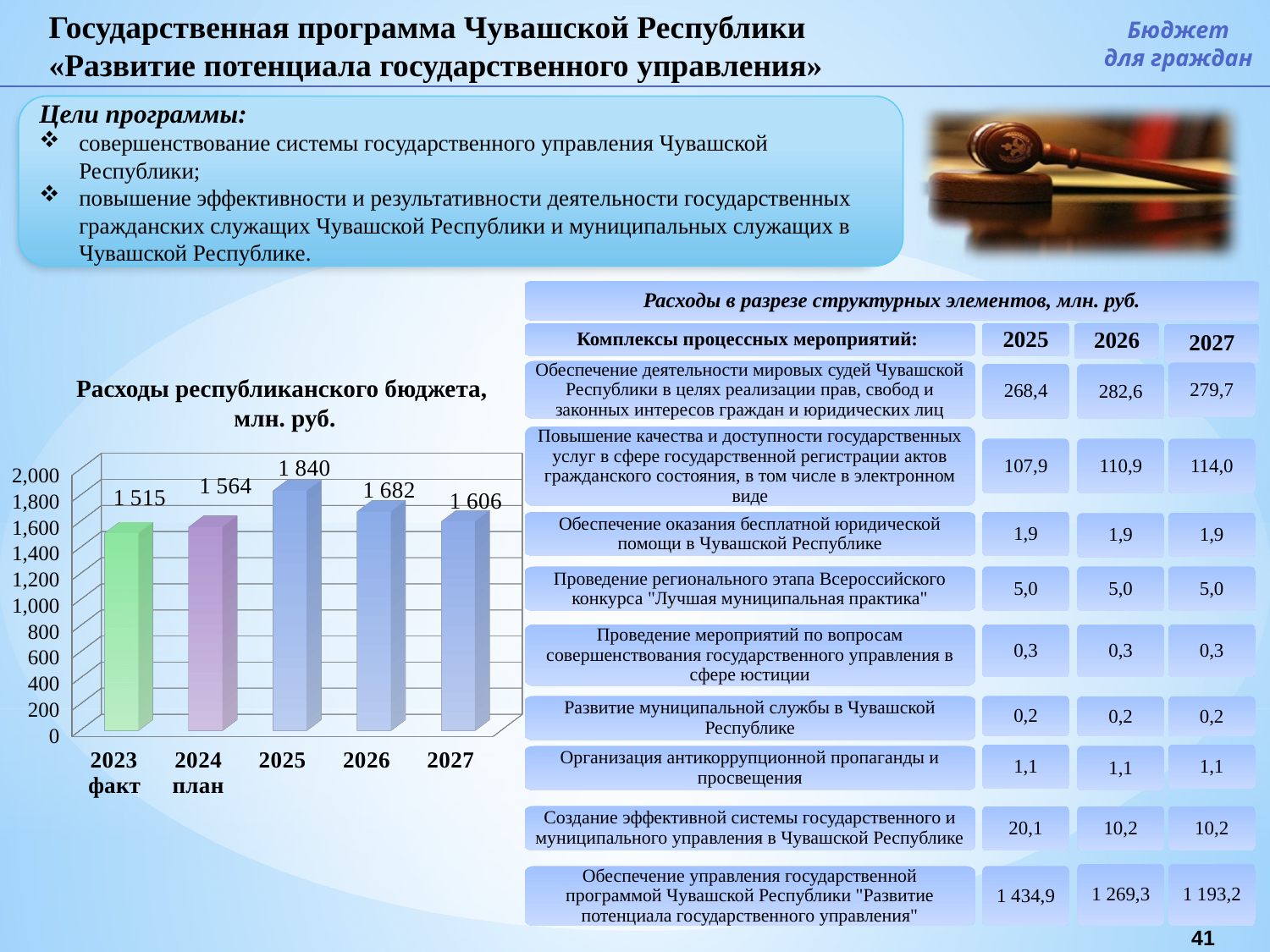
What is the value for 2023 факт in the chart "Расходы республиканского бюджета, млн. руб."? 1 515 Which year has the lowest value in the chart "Расходы республиканского бюджета, млн. руб."? 2023 факт In the chart "Расходы республиканского бюджета, млн. руб.", do the values rise or fall from 2025 to 2027? fall Which year has the highest value in the chart "Расходы республиканского бюджета, млн. руб."? 2025 How many bars are shown in the chart "Расходы республиканского бюджета, млн. руб."? 5 In the chart "Расходы республиканского бюджета, млн. руб.", what is the difference between the values for 2025 and 2026? 158 What is the value for 2025 in the chart "Расходы республиканского бюджета, млн. руб."? 1 840 What kind of chart is "Расходы республиканского бюджета, млн. руб."? bar chart In the chart "Расходы республиканского бюджета, млн. руб.", which is larger: the value for 2026 or the value for 2027? 2026 What is the value for 2027 in the chart "Расходы республиканского бюджета, млн. руб."? 1 606 In the chart "Расходы республиканского бюджета, млн. руб.", what is the difference between the values for 2024 план and 2023 факт? 49 In the chart "Расходы республиканского бюджета, млн. руб.", is the value for 2025 greater or less than 1,800? greater